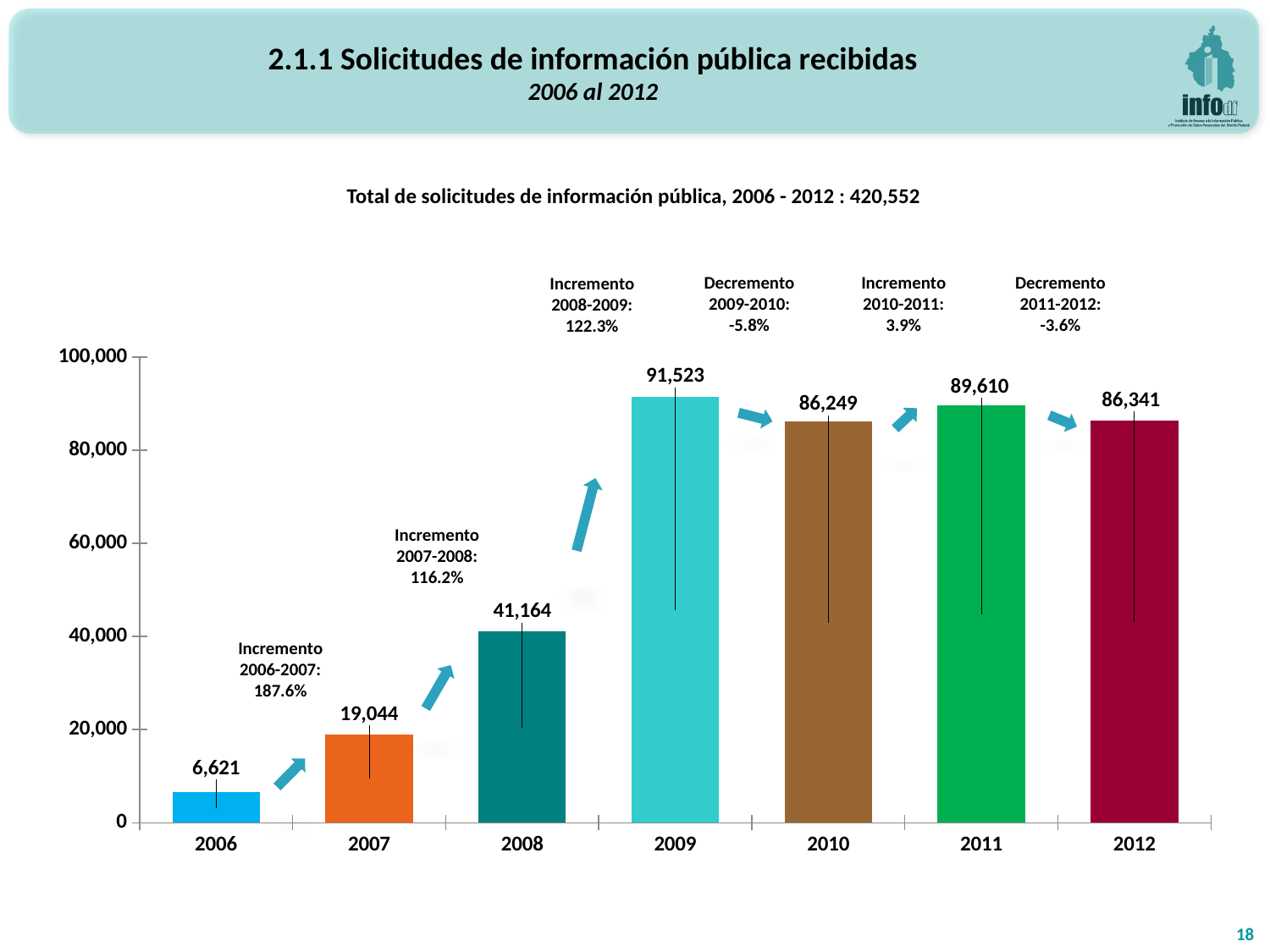
What is the value for 2011? 89,610 Which year has the highest value? 2009 Is the value for 2008 greater or less than 40,000? greater What is the value for 2009? 91,523 What is the difference between the values for 2008 and 2007? 22,120 Which is larger, the value for 2010 or the value for 2012? 2012 Do the values rise or fall from 2006 to 2009? rise Which year has the lowest value? 2006 What is the value for 2006? 6,621 How many years are shown on the x axis? 7 What kind of chart is shown on the slide? bar chart What percentage increase is annotated for 2006-2007? 187.6%